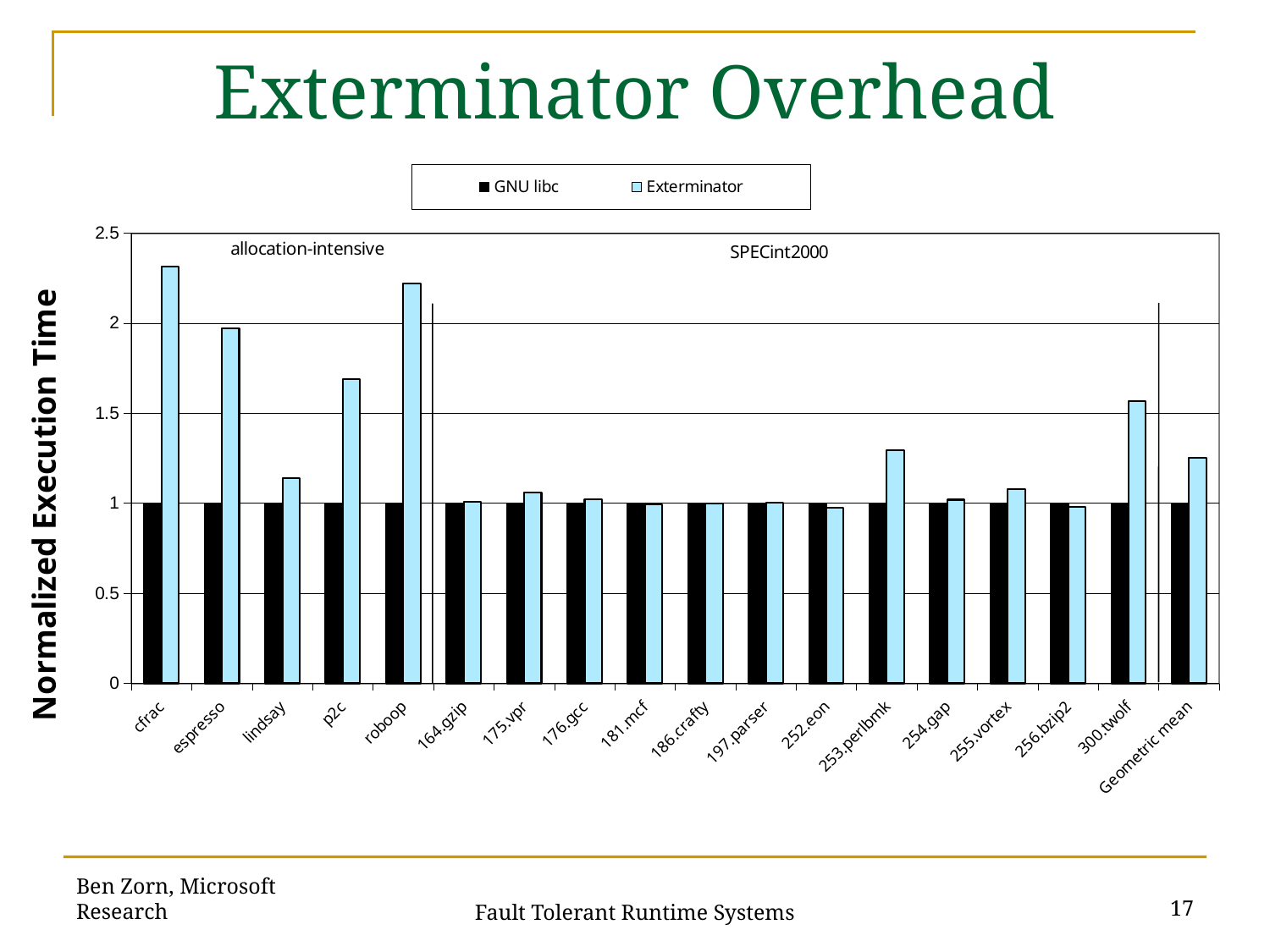
How many categories are shown along the x axis? 18 Is the Exterminator value for lindsay greater or less than 1.5? less Is the Exterminator value for cfrac greater or less than 2? greater What is the normalized execution time for GNU libc on cfrac? 1 Is the Exterminator value for p2c greater or less than 1.5? greater Which category has the highest Exterminator normalized execution time? cfrac Which has the larger Exterminator value, 300.twolf or 253.perlbmk? 300.twolf What is the label of the y axis? Normalized Execution Time What kind of chart is shown on the slide? bar chart Which has the larger Exterminator value, p2c or lindsay? p2c How many series does the legend list? 2